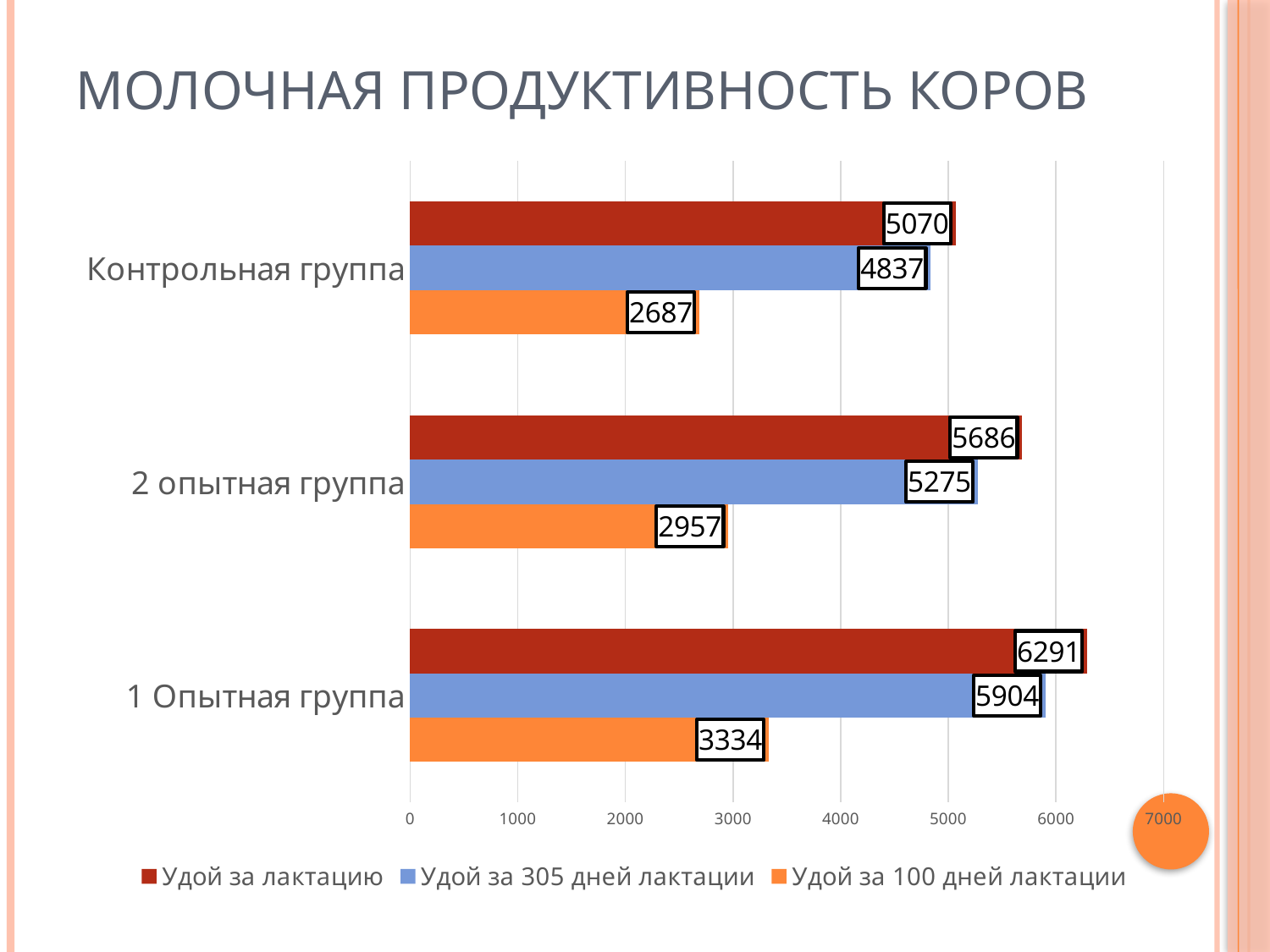
Which group has the highest value for 'Удой за лактацию'? 1 Опытная группа How many groups (categories) are shown on the chart? 3 What is the value of 'Удой за лактацию' for 'Контрольная группа'? 5070 Is the value of 'Удой за лактацию' for '1 Опытная группа' greater or less than 6000? greater What type of chart is shown on the slide? Bar chart What is the difference between 'Удой за лактацию' for '1 Опытная группа' and for 'Контрольная группа'? 1221 What is the value of 'Удой за 305 дней лактации' for '1 Опытная группа'? 5904 What is the value of 'Удой за 100 дней лактации' for '2 опытная группа'? 2957 Which is larger: 'Удой за 305 дней лактации' for '2 опытная группа' or 'Удой за лактацию' for 'Контрольная группа'? Удой за 305 дней лактации for 2 опытная группа Which group has the lowest value for 'Удой за 100 дней лактации'? Контрольная группа What is the difference between 'Удой за 305 дней лактации' and 'Удой за 100 дней лактации' for '2 опытная группа'? 2318 How many series does the legend list? 3